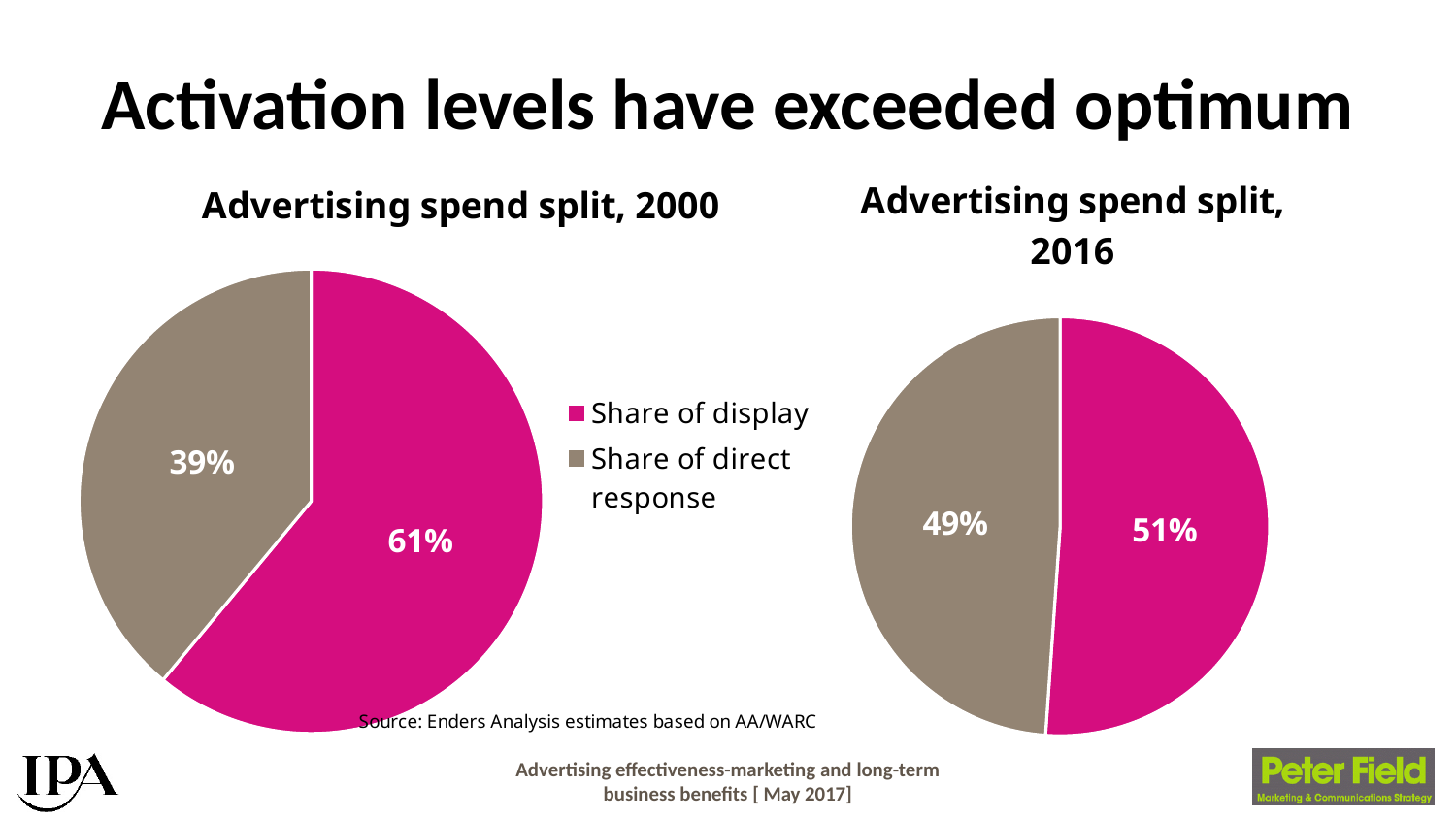
How many slices does the 'Advertising spend split, 2016' pie chart have? 2 In the 'Advertising spend split, 2000' chart, what is the share of display? 61% What kind of chart is the 'Advertising spend split, 2000' chart? Pie chart In the 'Advertising spend split, 2016' chart, what is the difference between the share of display and the share of direct response? 2% Which colour represents 'Share of direct response' in the pie charts? Grey How many entries does the legend list? 2 In the 'Advertising spend split, 2016' chart, what is the share of direct response? 49% In the 'Advertising spend split, 2000' chart, which category has the smallest slice? Share of direct response In the 'Advertising spend split, 2000' chart, what is the difference between the share of display and the share of direct response? 22% In the 'Advertising spend split, 2000' chart, what is the share of direct response? 39% In the 'Advertising spend split, 2016' chart, what is the share of display? 51% In the 'Advertising spend split, 2000' chart, which category has the largest slice? Share of display